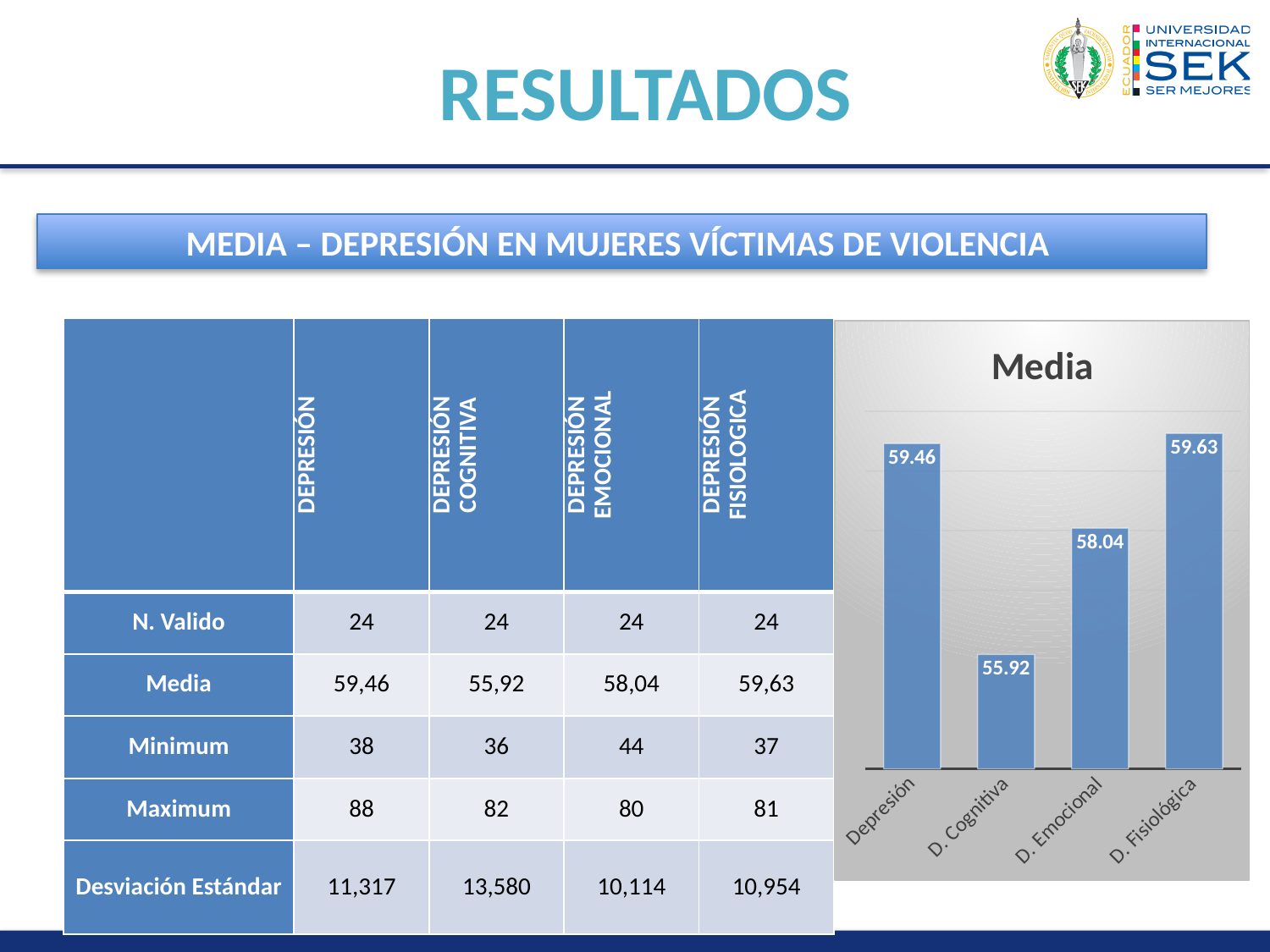
What is the value for D. Cognitiva in the Media chart? 55.92 What is the value for D. Emocional in the Media chart? 58.04 Which category has the lowest value in the Media chart? D. Cognitiva What is the value for Depresión in the Media chart? 59.46 What is the difference between the values for D. Fisiológica and D. Cognitiva in the Media chart? 3.71 How many categories are shown in the Media chart? 4 In the Media chart, which is larger: the value for D. Emocional or the value for D. Cognitiva? D. Emocional What kind of chart is the Media chart? Bar chart What is the difference between the values for Depresión and D. Emocional in the Media chart? 1.42 What is the title of the chart on the slide? Media Which category has the highest value in the Media chart? D. Fisiológica What is the value for D. Fisiológica in the Media chart? 59.63